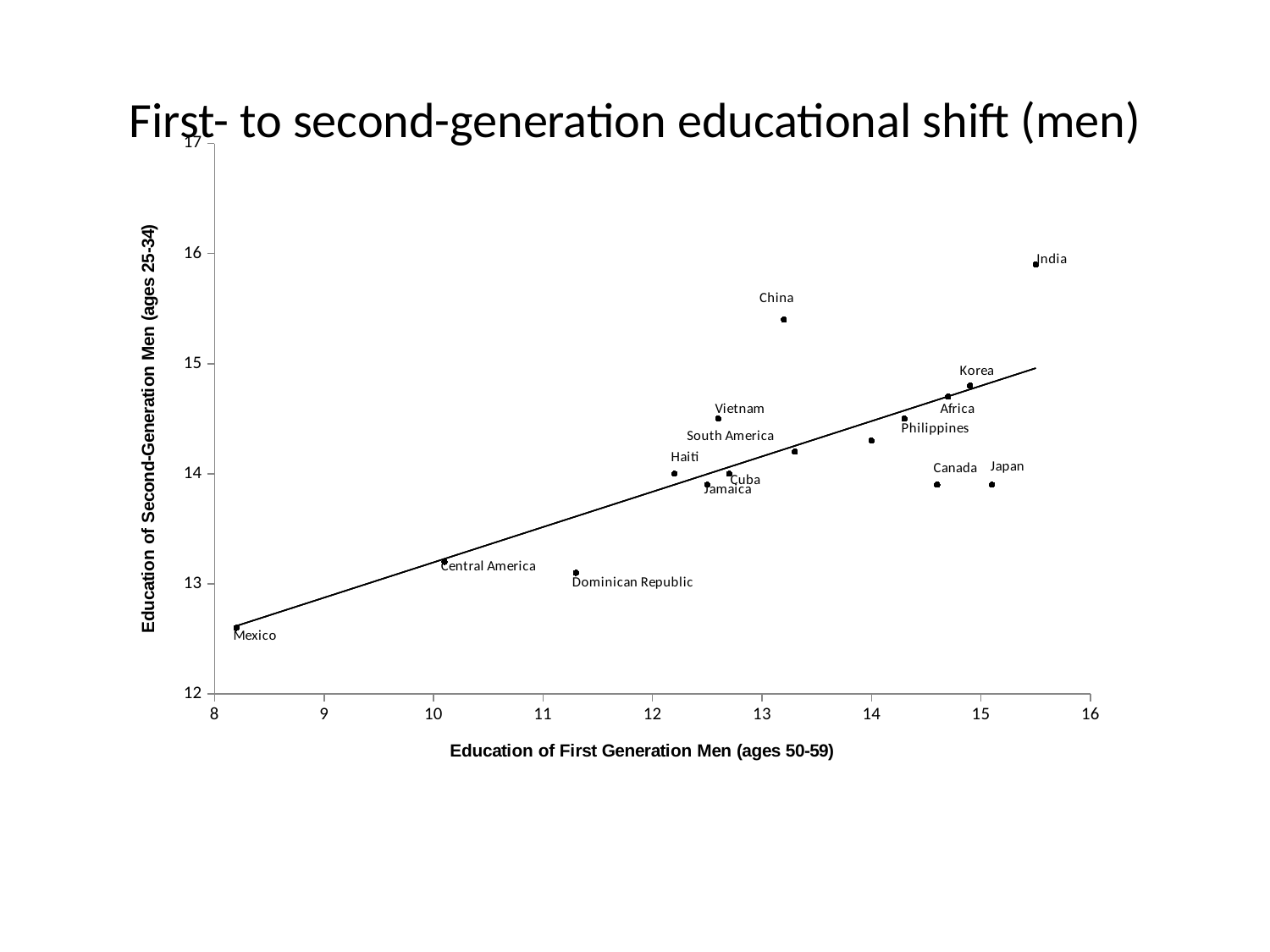
Is the second-generation education value for China greater or less than 15? greater What is the title of the x axis? Education of First Generation Men (ages 50-59) What kind of chart is shown on the slide? scatter plot Is the second-generation education value for Mexico greater or less than 13? less Which country has the lowest education of first generation men? Mexico Is the first generation education value for India greater or less than 15? greater Which has a higher second-generation education value, India or China? India Which country has the lowest education of second-generation men? Mexico Which has a higher second-generation education value, Korea or Japan? Korea Which country has the highest education of second-generation men? India Does the fitted line rise or fall as first generation education increases? rises